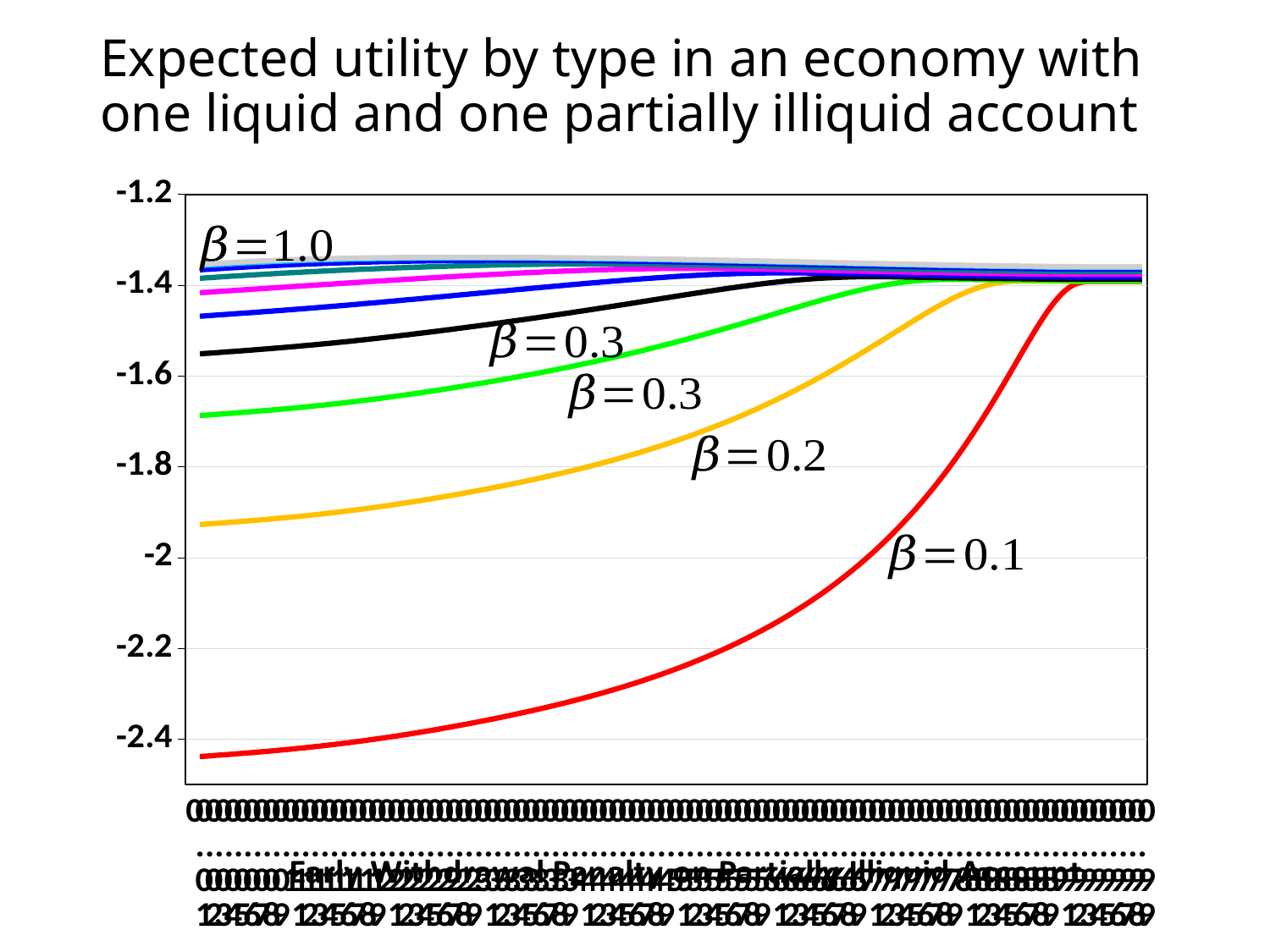
At the left edge of the chart, is the value of the β=0.2 curve greater or less than -1.8? less At the left edge of the chart, is the value of the β=0.1 curve greater or less than -2.4? less Which labelled curve has the lowest expected utility at the left edge of the chart? β=0.1 At the left edge of the chart, which curve has the larger expected utility, β=1.0 or β=0.2? β=1.0 What kind of chart is shown on the slide? line chart What is the title of the chart? Expected utility by type in an economy with one liquid and one partially illiquid account Does the β=0.1 curve rise or fall as you move from left to right along the x axis? rise At the left edge of the chart, is the value of the β=1.0 curve greater or less than -1.4? greater What is the x-axis title of the chart? Early Withdrawal Penalty on Partially Illiquid Account Does the β=0.2 curve rise or fall as you move from left to right along the x axis? rise Which labelled curve has the highest expected utility at the left edge of the chart? β=1.0 At the left edge of the chart, which curve has the larger expected utility, β=0.2 or β=0.1? β=0.2